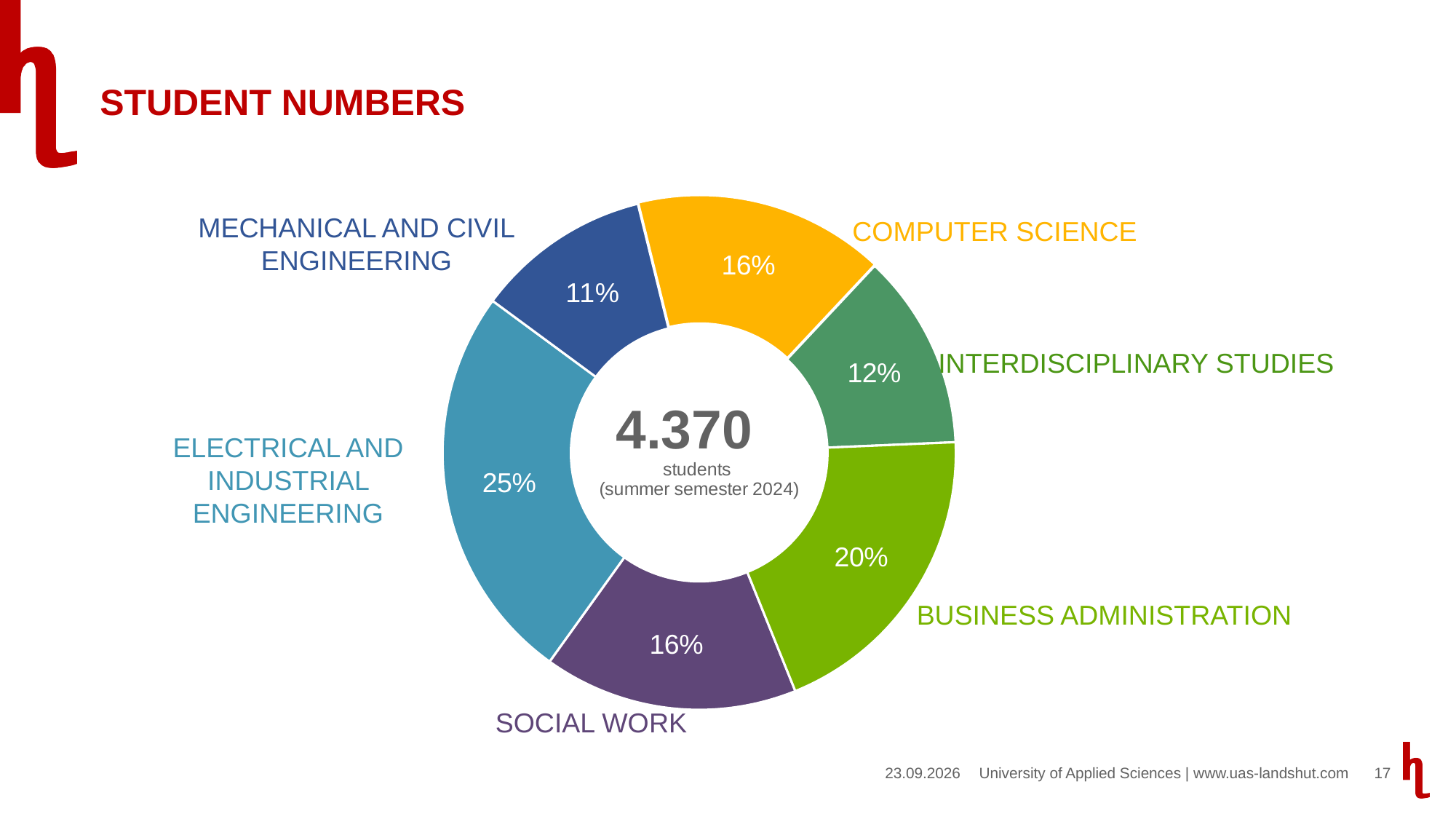
Which field has the smallest share of students? Mechanical and Civil Engineering What percentage of students are in Interdisciplinary Studies? 12% How many fields of study are shown in the chart? 6 What kind of chart is shown on the slide? Pie chart (doughnut) What percentage of students are in Business Administration? 20% Which semester does the student data refer to? Summer semester 2024 What percentage of students are in Mechanical and Civil Engineering? 11% What percentage of students are in Electrical and Industrial Engineering? 25% Which field has the largest share of students? Electrical and Industrial Engineering What total number of students is shown in the centre of the chart? 4.370 Which has a larger share of students, Computer Science or Interdisciplinary Studies? Computer Science What is the difference in percentage points between Electrical and Industrial Engineering and Business Administration? 5